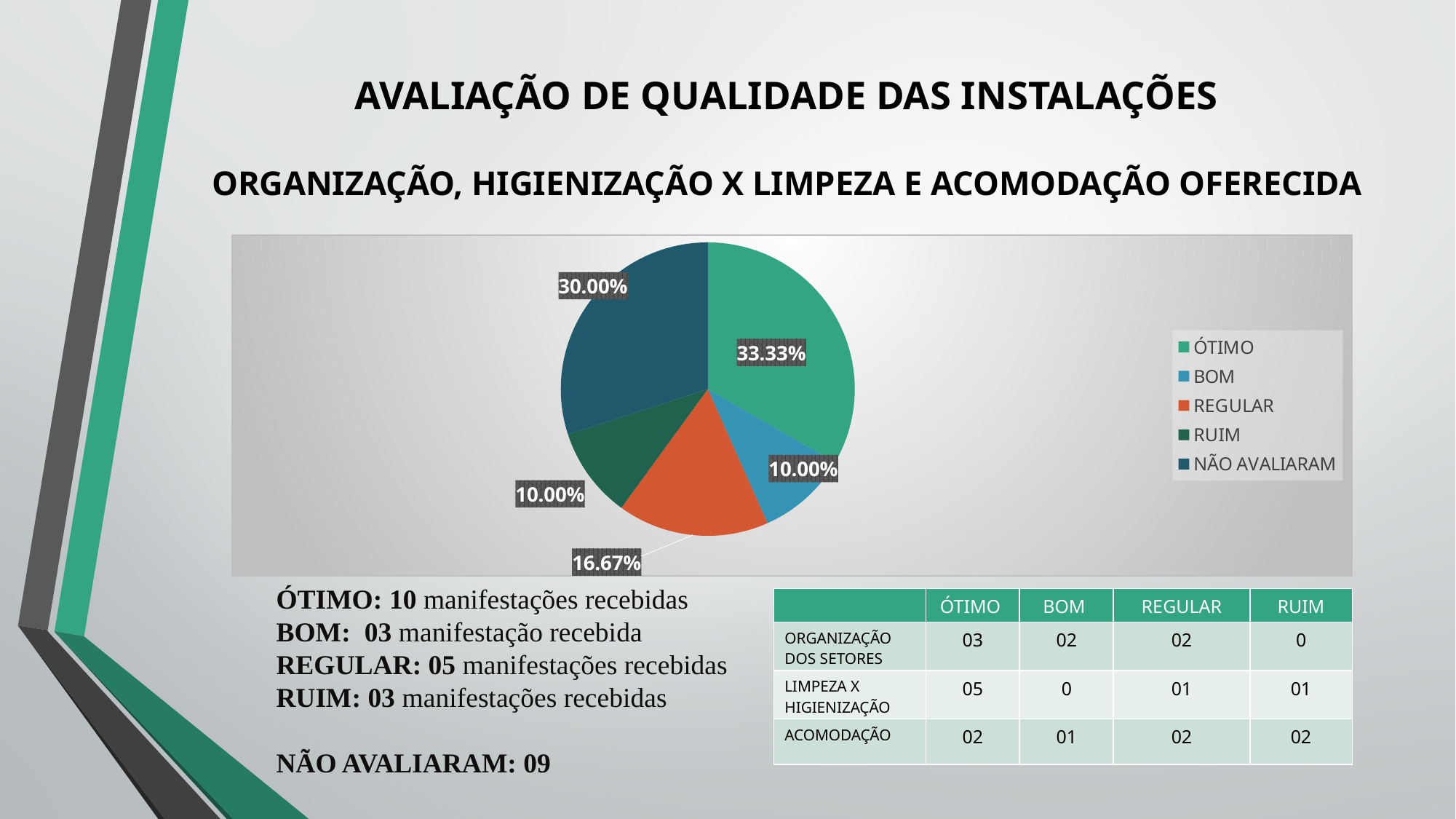
What percentage of the pie does REGULAR represent? 16.67% What percentage of the pie does BOM represent? 10.00% How many slices does the pie chart have? 5 What kind of chart is shown on the slide? Pie chart What percentage of the pie does RUIM represent? 10.00% Which is larger in the pie chart, ÓTIMO or NÃO AVALIARAM? ÓTIMO Which slice of the pie chart is the largest? ÓTIMO What percentage of the pie does ÓTIMO represent? 33.33% How many entries does the pie chart's legend list? 5 What is the difference in percentage points between the ÓTIMO slice and the NÃO AVALIARAM slice? 3.33% What percentage of the pie does NÃO AVALIARAM represent? 30.00% What is the difference in percentage points between the REGULAR slice and the BOM slice? 6.67%